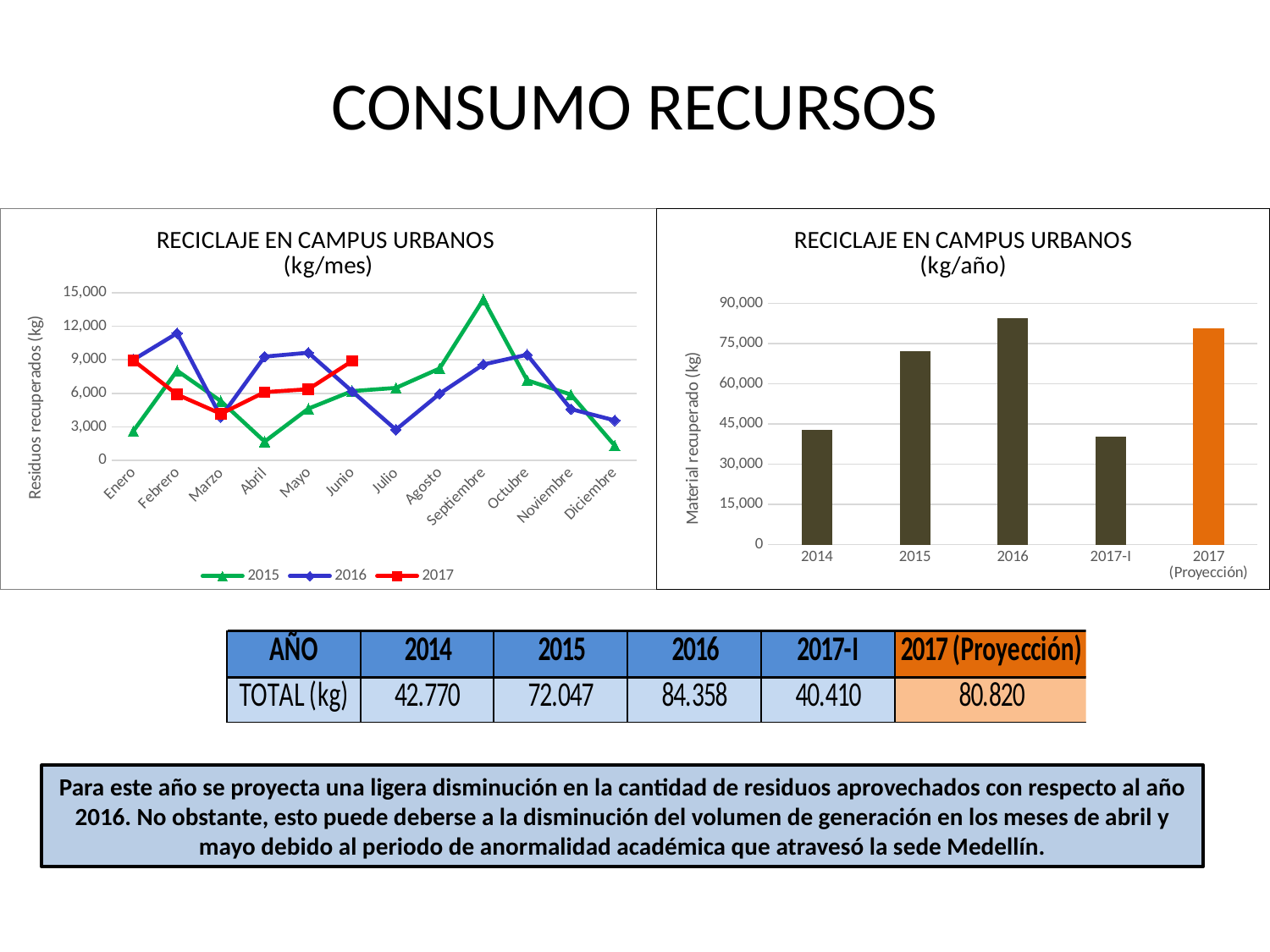
What type of chart is the 'RECICLAJE EN CAMPUS URBANOS (kg/año)' chart on the right? bar chart How many categories are shown on the x axis of the 'RECICLAJE EN CAMPUS URBANOS (kg/año)' chart? 5 How many series does the legend of the 'RECICLAJE EN CAMPUS URBANOS (kg/mes)' chart list? 3 In the 'RECICLAJE EN CAMPUS URBANOS (kg/mes)' chart, in which month does the 2016 series reach its lowest value? Julio In the 'RECICLAJE EN CAMPUS URBANOS (kg/mes)' chart, is the 2015 value for Septiembre greater or less than 12,000? greater In the 'RECICLAJE EN CAMPUS URBANOS (kg/mes)' chart, is the 2017 value for Marzo greater or less than 6,000? less In the 'RECICLAJE EN CAMPUS URBANOS (kg/año)' chart, is the bar for 2015 greater or less than 60,000? greater In the 'RECICLAJE EN CAMPUS URBANOS (kg/año)' chart, which bar is taller, 2015 or 2016? 2016 What type of chart is the 'RECICLAJE EN CAMPUS URBANOS (kg/mes)' chart on the left? line chart In the 'RECICLAJE EN CAMPUS URBANOS (kg/mes)' chart, in which month does the 2015 series reach its highest value? Septiembre In the 'RECICLAJE EN CAMPUS URBANOS (kg/año)' chart, which year has the highest bar? 2016